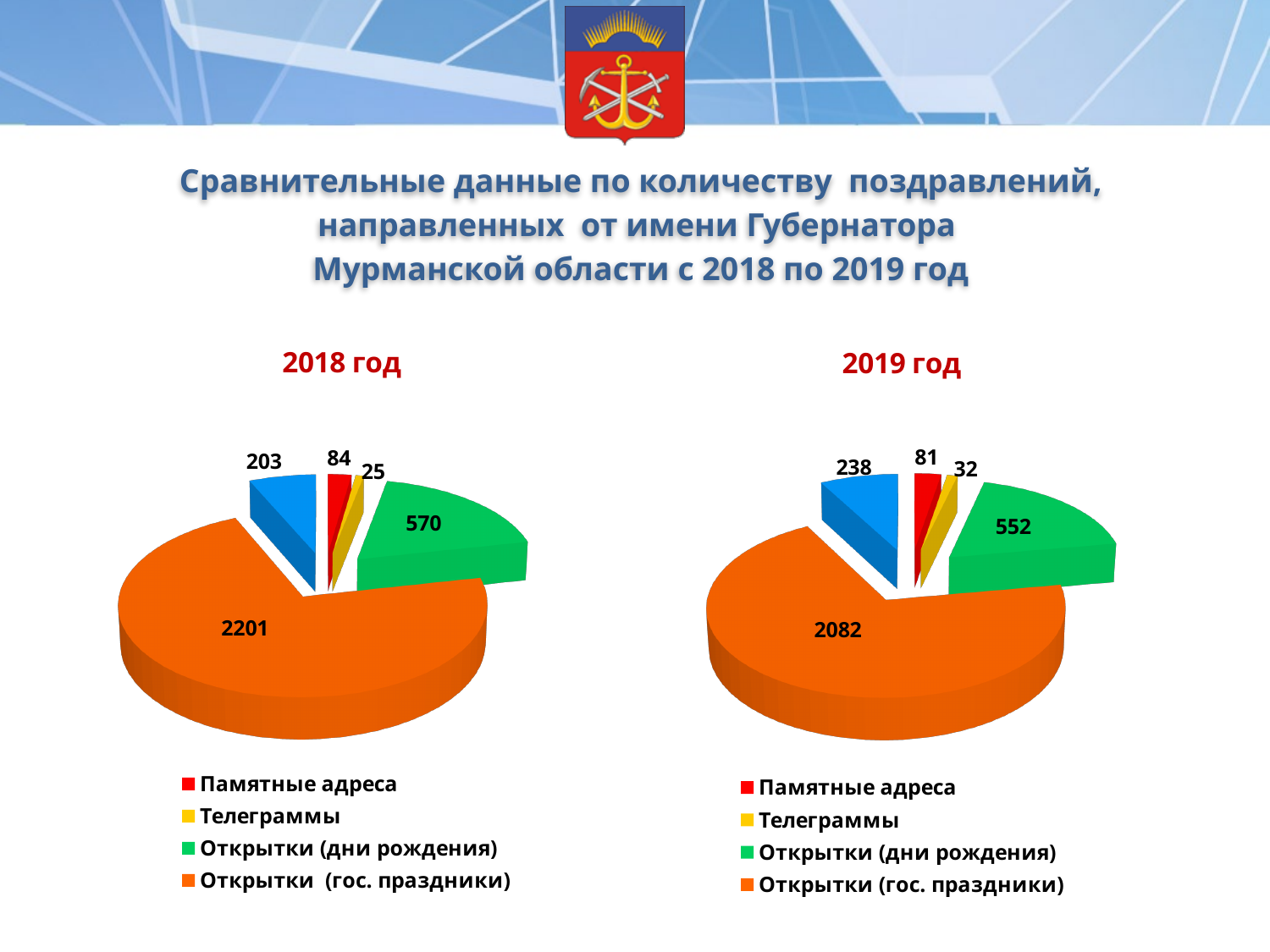
In the 2019 год chart, what is the value for Памятные адреса? 81 In the 2019 год chart, which category has the largest slice? Открытки (гос. праздники) In the 2018 год chart, what is the value for Открытки (гос. праздники)? 2201 In the 2018 год chart, what is the value for Телеграммы? 25 In the 2018 год chart, which is larger: Памятные адреса or Телеграммы? Памятные адреса How much larger is the value for Открытки (гос. праздники) in the 2018 год chart than in the 2019 год chart? 119 What type of chart is used for the 2018 год data? Pie chart In the 2018 год chart, which category has the smallest slice? Телеграммы How many entries does the legend of the 2019 год chart list? 4 How many slices does the 2018 год pie chart have? 5 In the 2019 год chart, what is the difference between Открытки (дни рождения) and Памятные адреса? 471 In the 2019 год chart, what is the value for Открытки (дни рождения)? 552